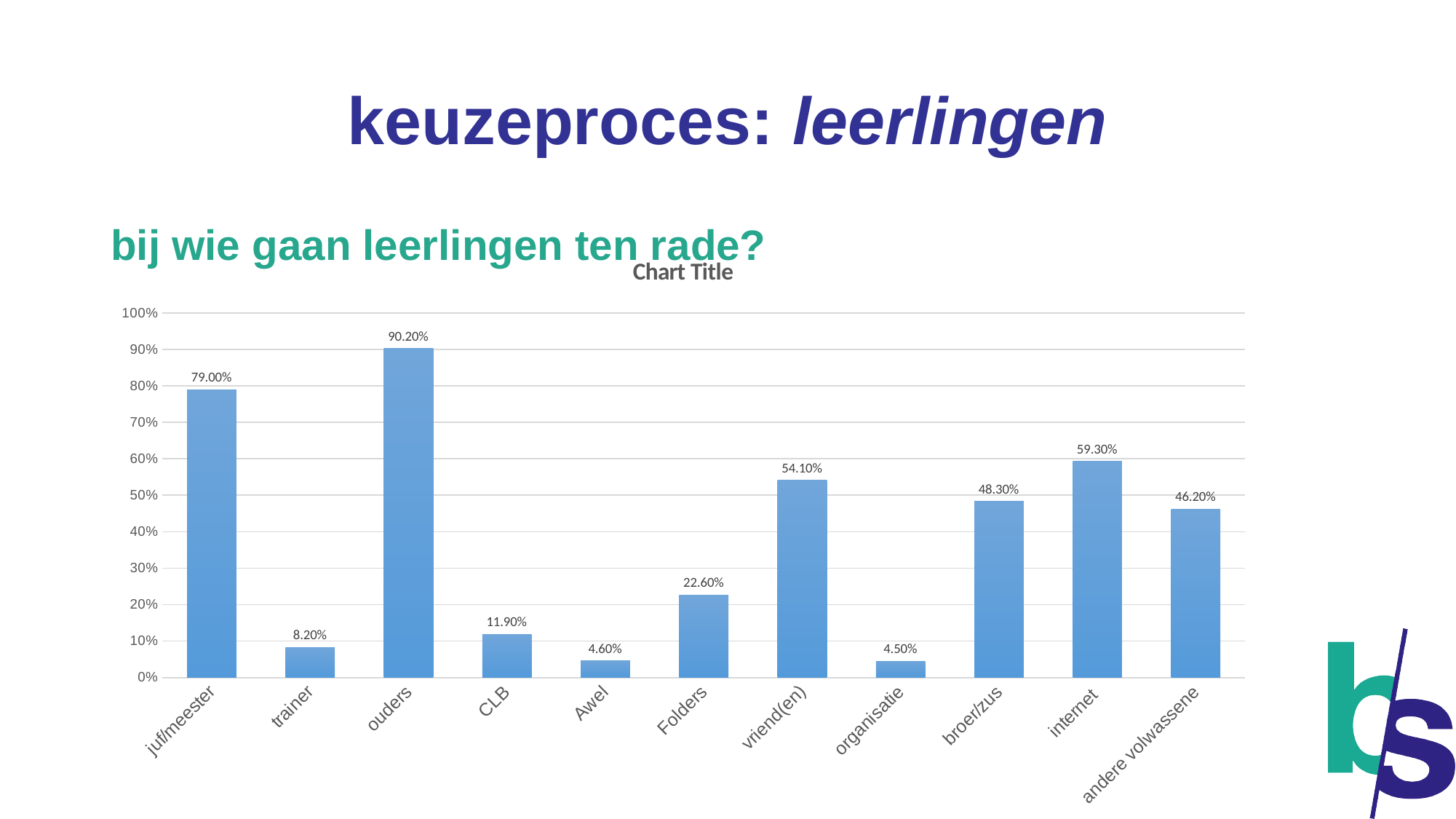
What is the value for internet? 59.30% What is the value for Folders? 22.60% What kind of chart is shown on the slide? bar chart What is the value for ouders? 90.20% Which category has the highest value? ouders What is the value for andere volwassene? 46.20% What is the difference between the values for ouders and juf/meester? 11.20% How many categories are shown on the x axis? 11 What is the title printed above the chart? Chart Title Which is larger, the value for broer/zus or the value for andere volwassene? broer/zus What is the difference between the values for internet and vriend(en)? 5.20% Which category has the lowest value? organisatie